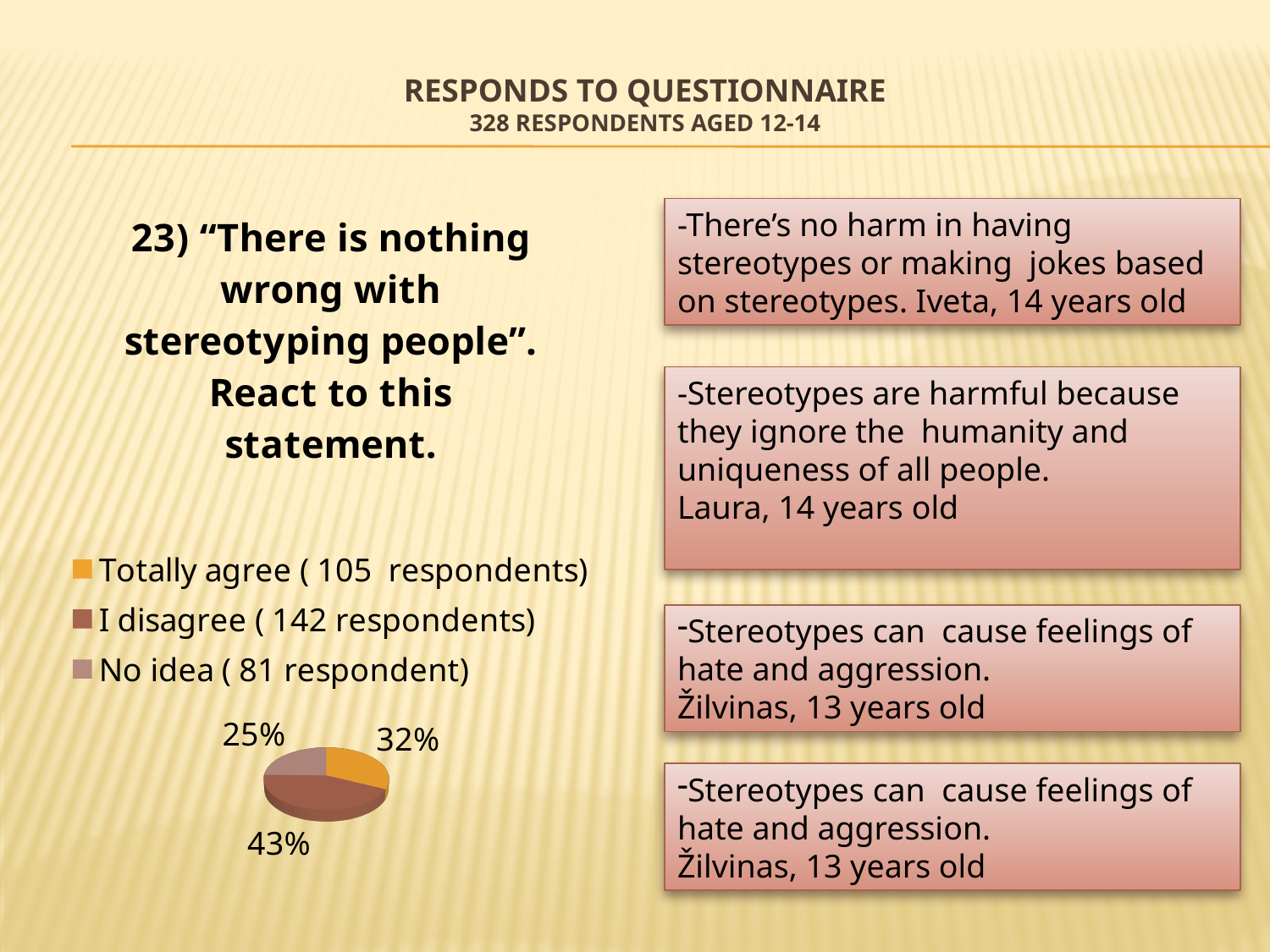
What percentage of the pie does "No idea" represent? 25% Which is larger, the "Totally agree" slice or the "No idea" slice? Totally agree What kind of chart is shown on the slide? pie chart What is the difference in percentage points between the "I disagree" slice and the "Totally agree" slice? 11 What percentage of the pie does "I disagree" represent? 43% How many slices does the pie chart have? 3 What colour is the "Totally agree" slice in the pie chart? orange How many respondents chose "I disagree" according to the legend? 142 What percentage of the pie does "Totally agree" represent? 32% Which response has the smallest slice of the pie? No idea Which response has the largest slice of the pie? I disagree How many respondents chose "Totally agree" according to the legend? 105